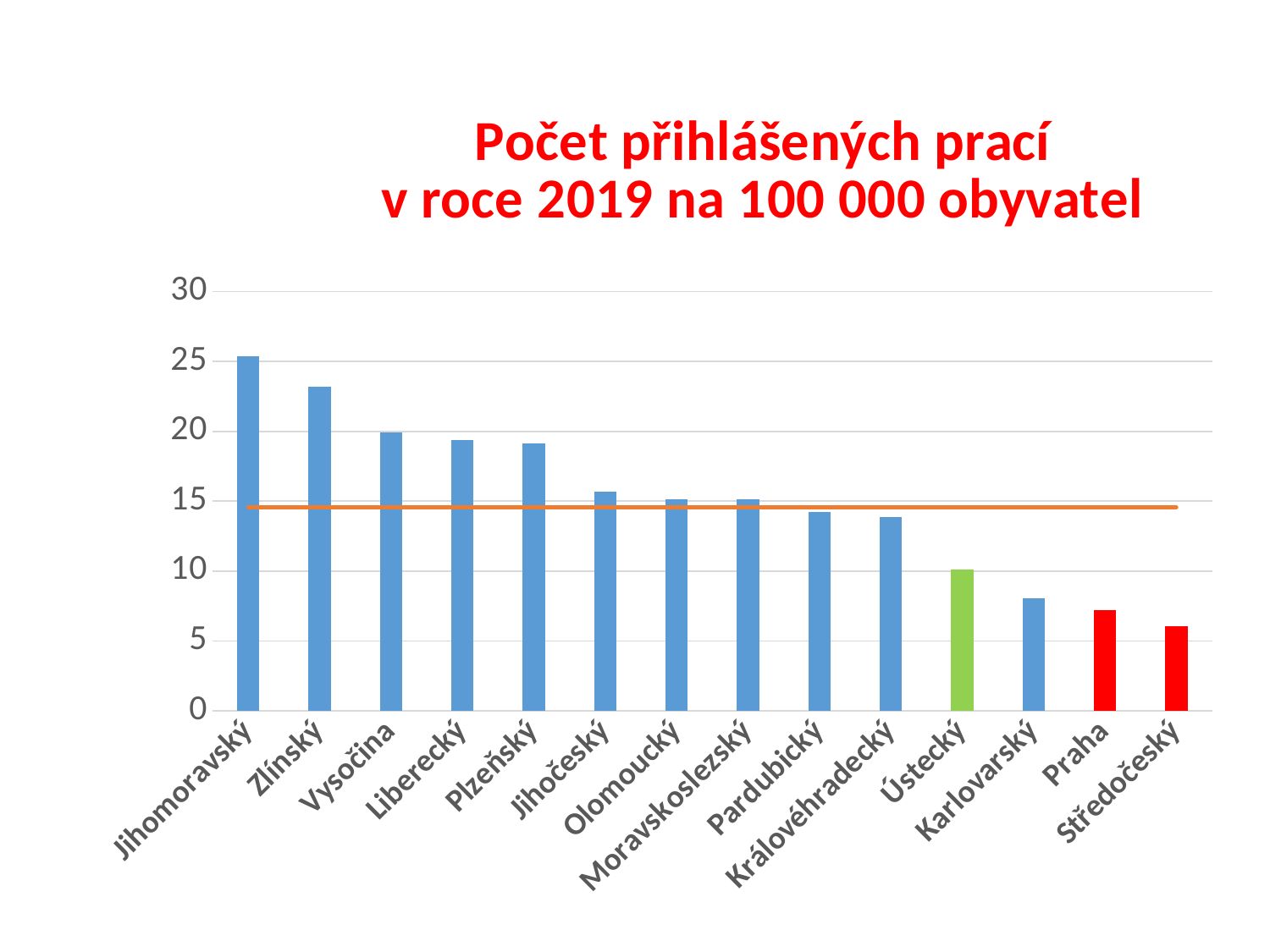
How many regions (categories) are plotted on the x axis? 14 Which has the larger value, Zlínský or Vysočina? Zlínský What kind of chart is shown on the slide? bar chart Which two regions are shown with red bars? Praha and Středočeský Which region has the highest value? Jihomoravský Is the value for Liberecký greater or less than 20? less Is the value for Jihomoravský greater or less than 20? greater What is the title of the chart? Počet přihlášených prací v roce 2019 na 100 000 obyvatel Do the values rise or fall from left to right along the x axis? fall Which region has the lowest value? Středočeský Is the value for Karlovarský greater or less than 10? less